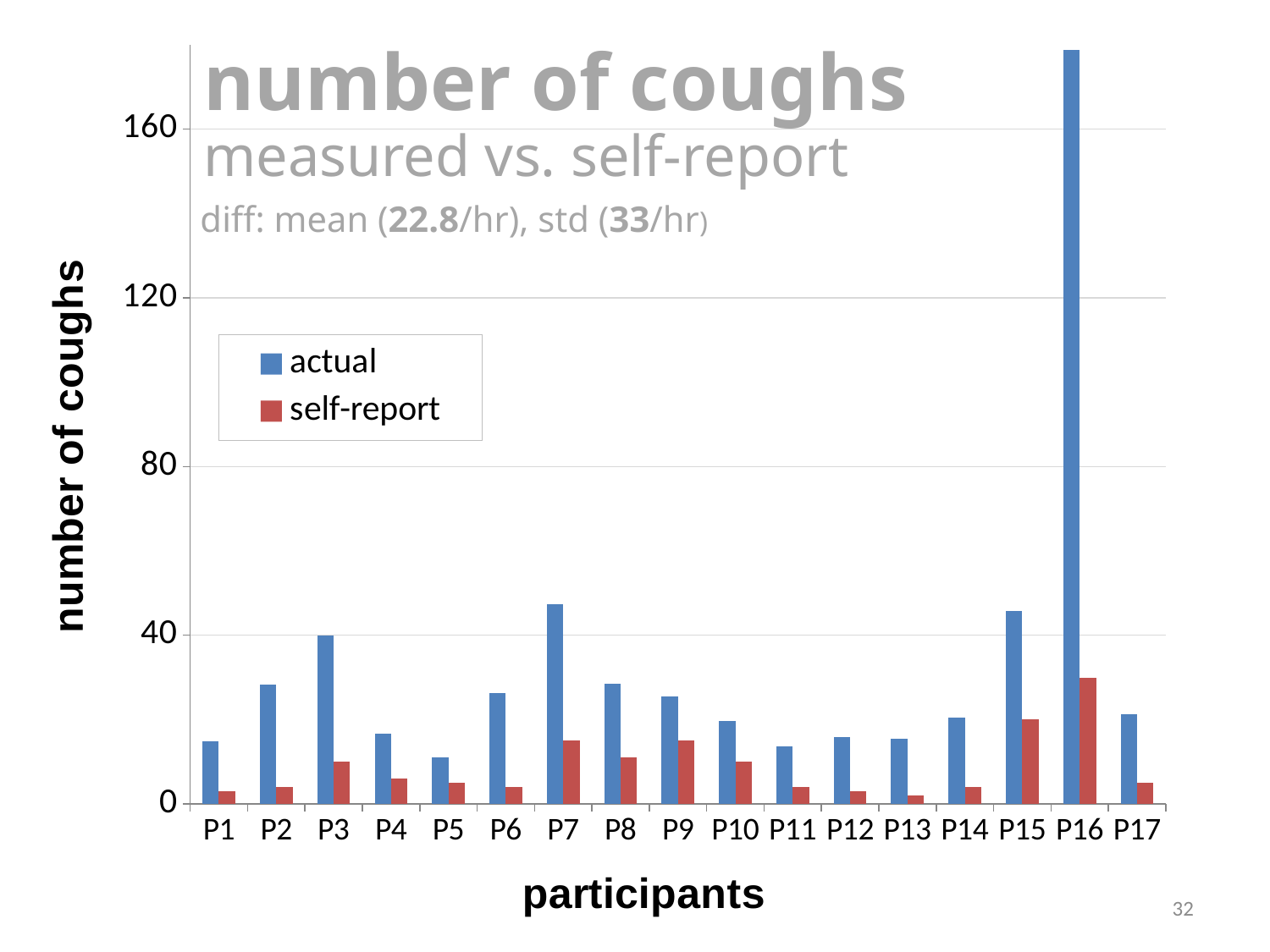
Which participant has the highest self-report number of coughs? P16 Which is larger, the actual value for P2 or the actual value for P1? P2 How many participants are shown on the x axis of the chart? 17 Is the actual value for P16 greater or less than 160? greater How many series does the chart's legend list? 2 Which participant has the highest actual number of coughs? P16 Is the actual value for P1 greater or less than 40? less Is the actual value for P7 greater or less than 40? greater What are the two series named in the chart's legend? actual and self-report Which is larger, the actual value for P7 or the actual value for P3? P7 What kind of chart is shown on the slide? bar chart